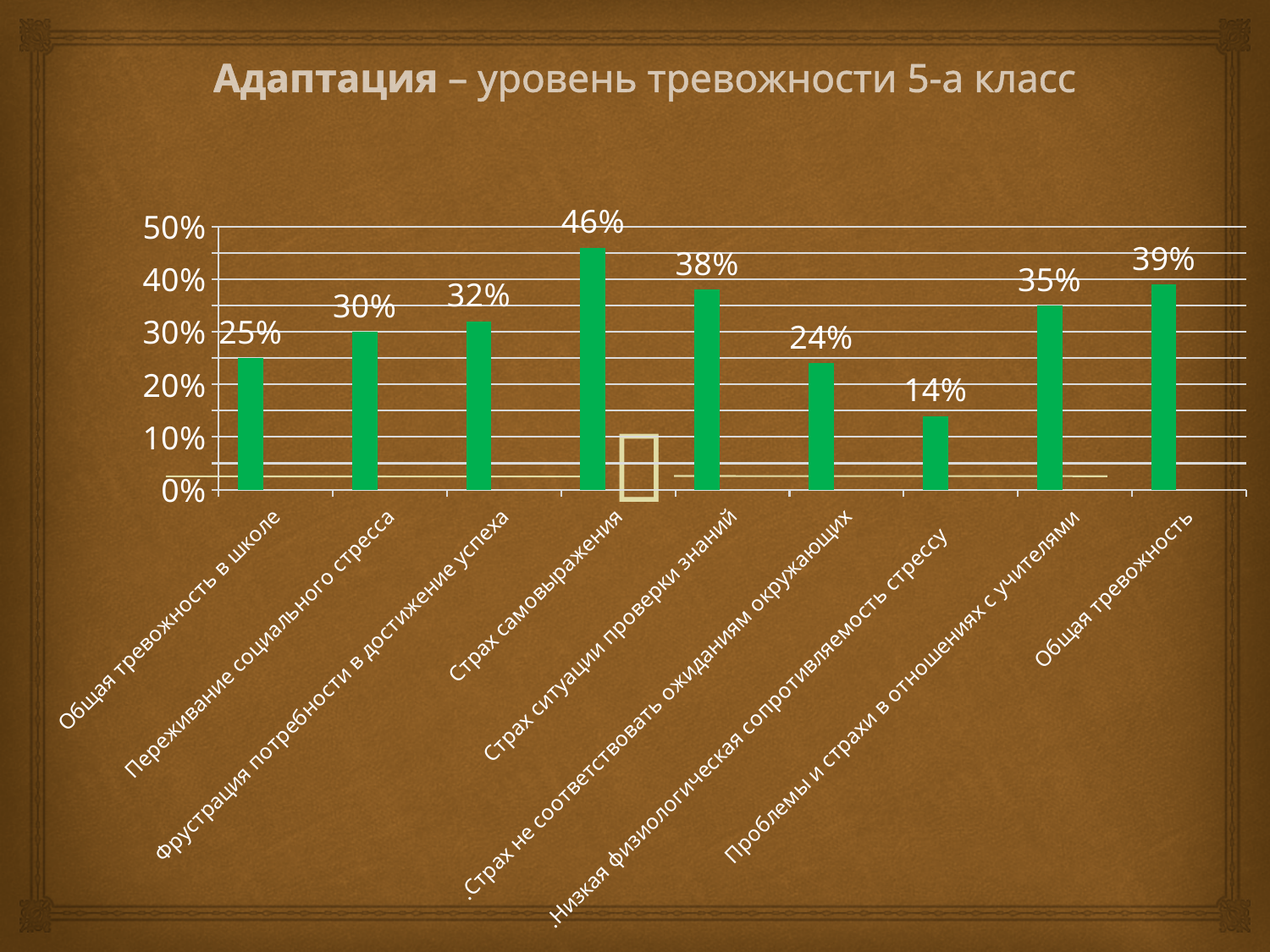
Is the value for Проблемы и страхи в отношениях с учителями greater or less than 30%? greater Which category has the lowest value? Низкая физиологическая сопротивляемость стрессу How many categories are shown on the chart? 9 What is the value for Общая тревожность? 39% What is the difference between the values for Страх самовыражения and Страх ситуации проверки знаний? 8% What kind of chart is shown on the slide? bar chart Which is larger: the value for Общая тревожность в школе or the value for Страх не соответствовать ожиданиям окружающих? Общая тревожность в школе What is the title of the chart? Адаптация – уровень тревожности 5-а класс Which category has the highest value? Страх самовыражения What is the value for Страх самовыражения? 46% What is the value for Низкая физиологическая сопротивляемость стрессу? 14% What is the value for Переживание социального стресса? 30%